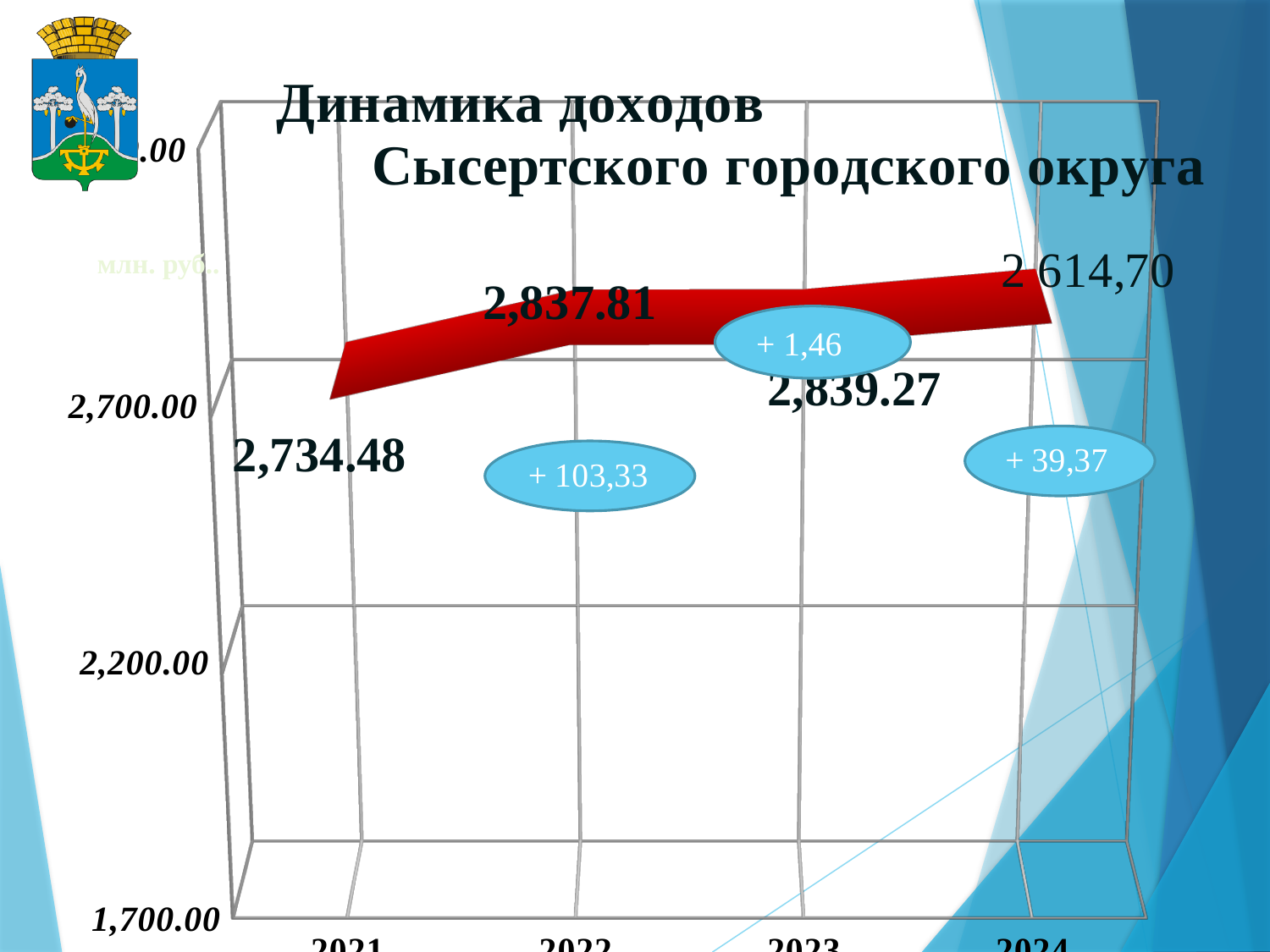
Which is larger, the value for 2021 or the value for 2022? 2022 Is the value for 2021 greater or less than 2,700.00? greater What is the difference between the values for 2022 and 2021? 103.33 What is the title of the chart? Динамика доходов Сысертского городского округа Is the value for 2023 greater or less than 2,200.00? greater What is the value for 2022? 2,837.81 Do the values rise or fall from 2021 to 2023? rise What is the value for 2021? 2,734.48 What kind of chart is shown on the slide? line chart What is the difference between the values for 2023 and 2022? 1.46 How many years are shown on the x axis? 4 What is the value for 2023? 2,839.27